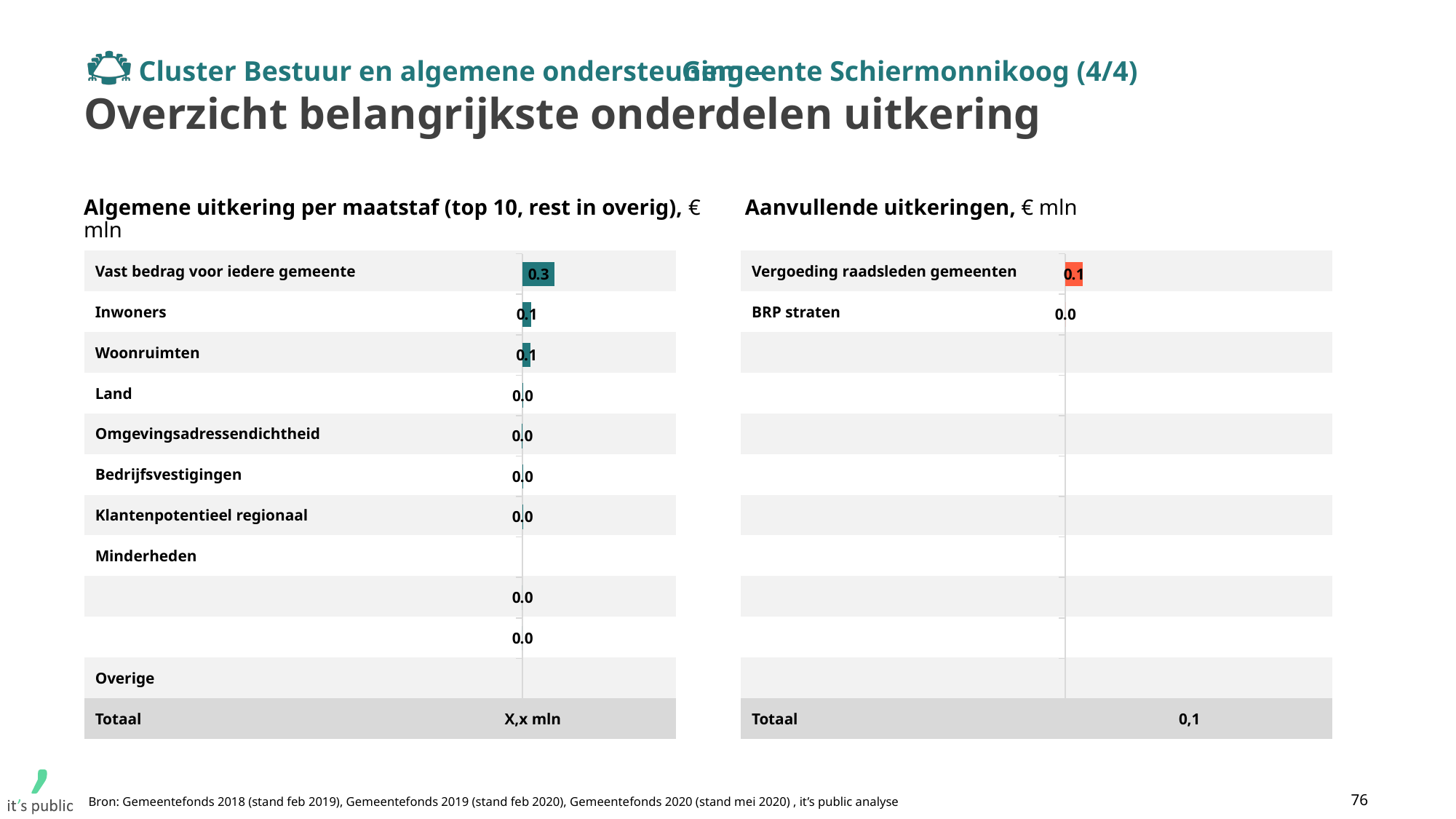
In the left chart (Algemene uitkering per maatstaf), what is the difference between Vast bedrag voor iedere gemeente and Inwoners? 0.2 In the left chart (Algemene uitkering per maatstaf), what is the value for Woonruimten? 0.1 In the left chart (Algemene uitkering per maatstaf), which category has the highest value? Vast bedrag voor iedere gemeente In the left chart (Algemene uitkering per maatstaf), what is the value for Land? 0.0 In the right chart (Aanvullende uitkeringen), what is the total shown in the Totaal row? 0,1 In the left chart (Algemene uitkering per maatstaf), which is larger: Vast bedrag voor iedere gemeente or Woonruimten? Vast bedrag voor iedere gemeente What kind of chart is the right chart (Aanvullende uitkeringen)? Bar chart In the left chart (Algemene uitkering per maatstaf), what is the value for Inwoners? 0.1 What unit is stated in the title of the right chart (Aanvullende uitkeringen)? € mln In the left chart (Algemene uitkering per maatstaf), what is the value for Vast bedrag voor iedere gemeente? 0.3 In the right chart (Aanvullende uitkeringen), what is the value for BRP straten? 0.0 In the right chart (Aanvullende uitkeringen), what is the value for Vergoeding raadsleden gemeenten? 0.1